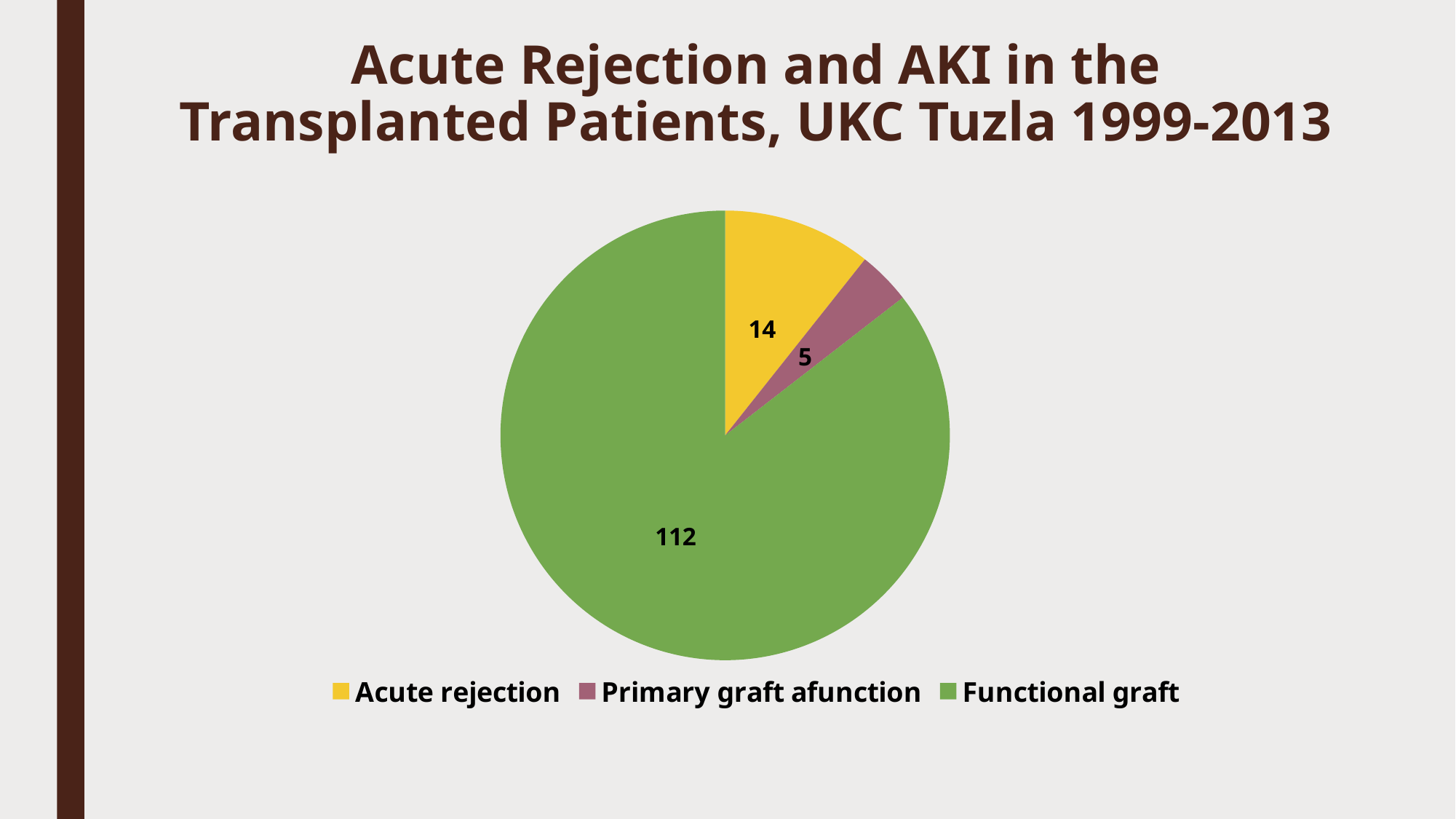
What type of chart is shown on the slide? Pie chart What is the total of all slices in the pie chart? 131 What is the difference between the values for Functional graft and Acute rejection? 98 What is the value for Acute rejection? 14 How many categories does the pie chart show? 3 What colour is the Functional graft slice? Green What is the value for Functional graft? 112 What is the difference between the values for Acute rejection and Primary graft afunction? 9 What is the value for Primary graft afunction? 5 Which category has the smallest slice? Primary graft afunction Which is larger, Acute rejection or Primary graft afunction? Acute rejection Which category has the largest slice? Functional graft